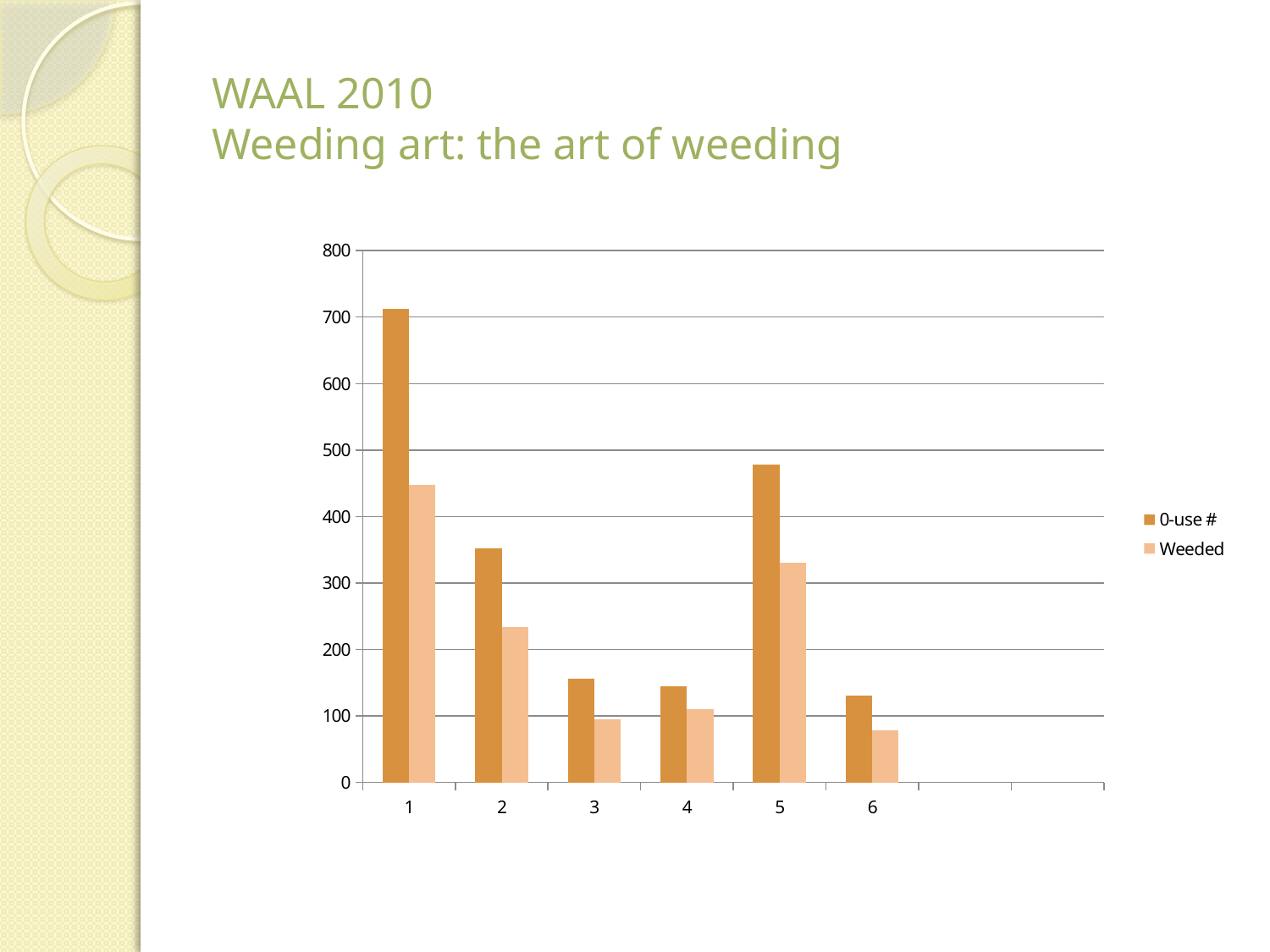
What kind of chart is shown on the slide? bar chart Which category has the highest value for the Weeded series? 1 Is the 0-use # value for category 5 greater or less than 500? less How many categories are shown on the x axis? 6 How many series does the legend list? 2 For category 1, which series has the larger value, 0-use # or Weeded? 0-use # Is the 0-use # value for category 1 greater or less than 600? greater Is the Weeded value for category 1 greater or less than 400? greater Which has the larger 0-use # value, category 2 or category 5? category 5 What are the two entries listed in the legend? 0-use # and Weeded Which category has the highest value for the 0-use # series? 1